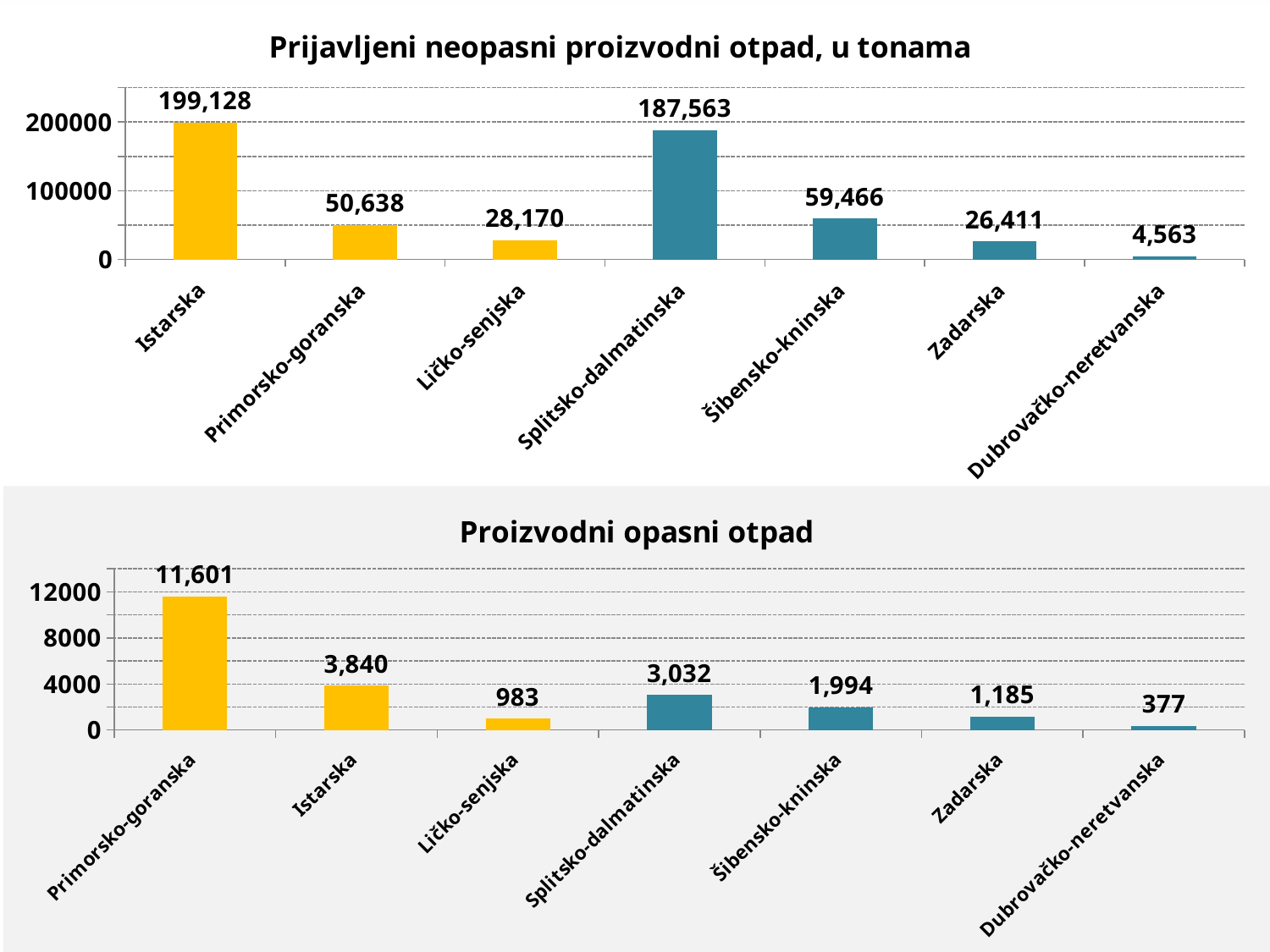
In the chart titled "Proizvodni opasni otpad", what is the value for Primorsko-goranska? 11,601 In the chart titled "Proizvodni opasni otpad", is the value for Istarska greater or less than 4000? less In the chart titled "Prijavljeni neopasni proizvodni otpad, u tonama", what is the value for Istarska? 199,128 In the chart titled "Prijavljeni neopasni proizvodni otpad, u tonama", what is the value for Šibensko-kninska? 59,466 In the chart titled "Proizvodni opasni otpad", which category has the highest value? Primorsko-goranska In the chart titled "Prijavljeni neopasni proizvodni otpad, u tonama", which is larger, Primorsko-goranska or Ličko-senjska? Primorsko-goranska In the chart titled "Proizvodni opasni otpad", what is the value for Zadarska? 1,185 In the chart titled "Prijavljeni neopasni proizvodni otpad, u tonama", what is the difference between Istarska and Splitsko-dalmatinska? 11,565 What kind of chart is the chart titled "Proizvodni opasni otpad"? Bar chart In the chart titled "Proizvodni opasni otpad", what is the difference between Istarska and Splitsko-dalmatinska? 808 In the chart titled "Prijavljeni neopasni proizvodni otpad, u tonama", which category has the lowest value? Dubrovačko-neretvanska In the chart titled "Prijavljeni neopasni proizvodni otpad, u tonama", how many categories are shown? 7